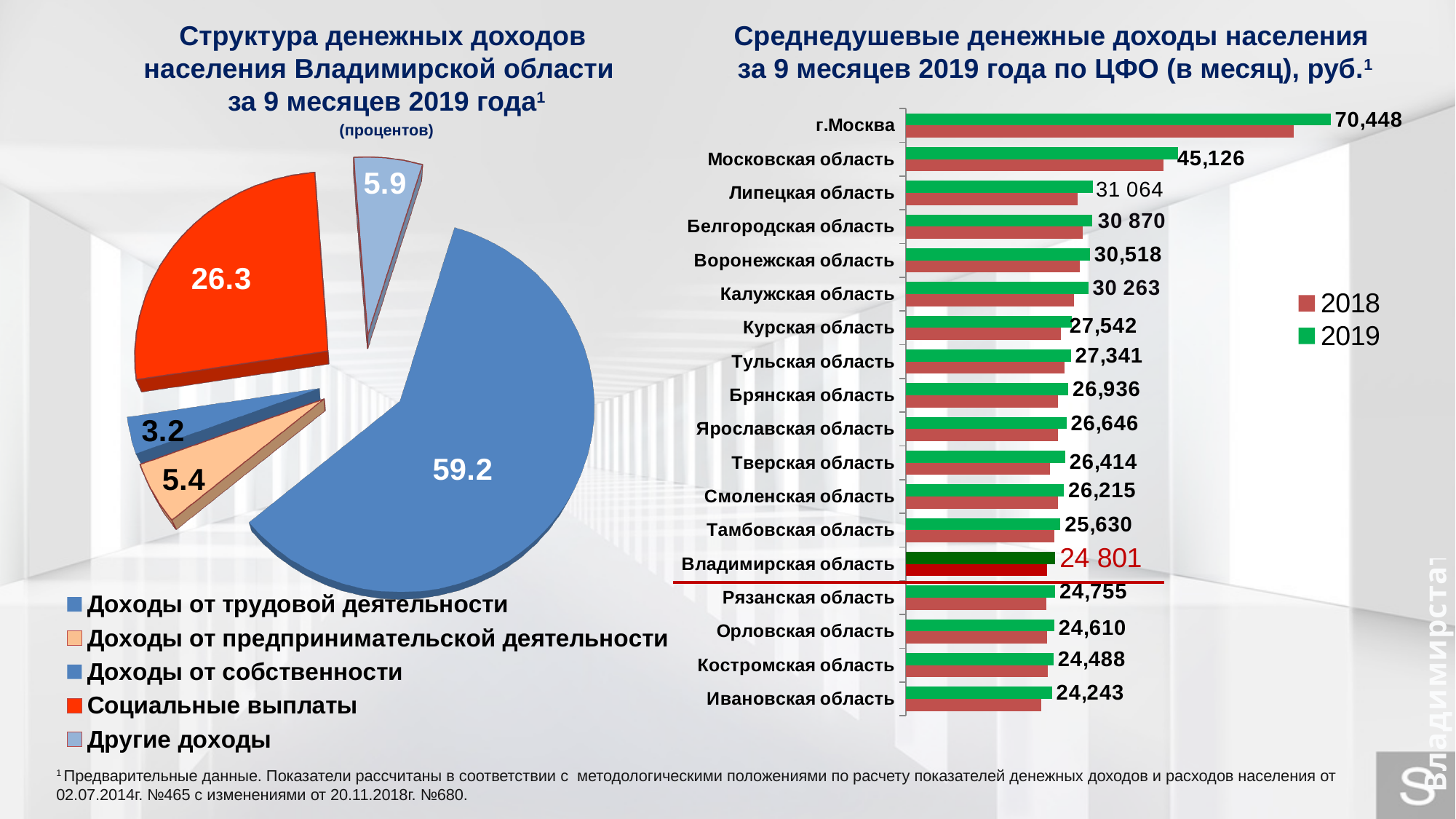
On the left pie chart, what share is shown for Социальные выплаты? 26.3 What type of chart is shown on the right side of the slide? Bar chart On the left pie chart, which category has the smallest share? Доходы от собственности On the right bar chart, how many regions are listed? 18 On the right bar chart, how many series does the legend list? 2 On the left pie chart, what is the difference between the shares for Социальные выплаты and Другие доходы? 20.4 On the right bar chart, what is the 2019 value for Владимирская область? 24 801 On the left pie chart, how many categories does the legend list? 5 On the right bar chart, which is larger for 2019: Курская область or Тульская область? Курская область On the right bar chart, what is the 2019 value for г.Москва? 70,448 On the right bar chart, which region has the lowest 2019 value? Ивановская область On the left pie chart, what share is shown for Доходы от трудовой деятельности? 59.2